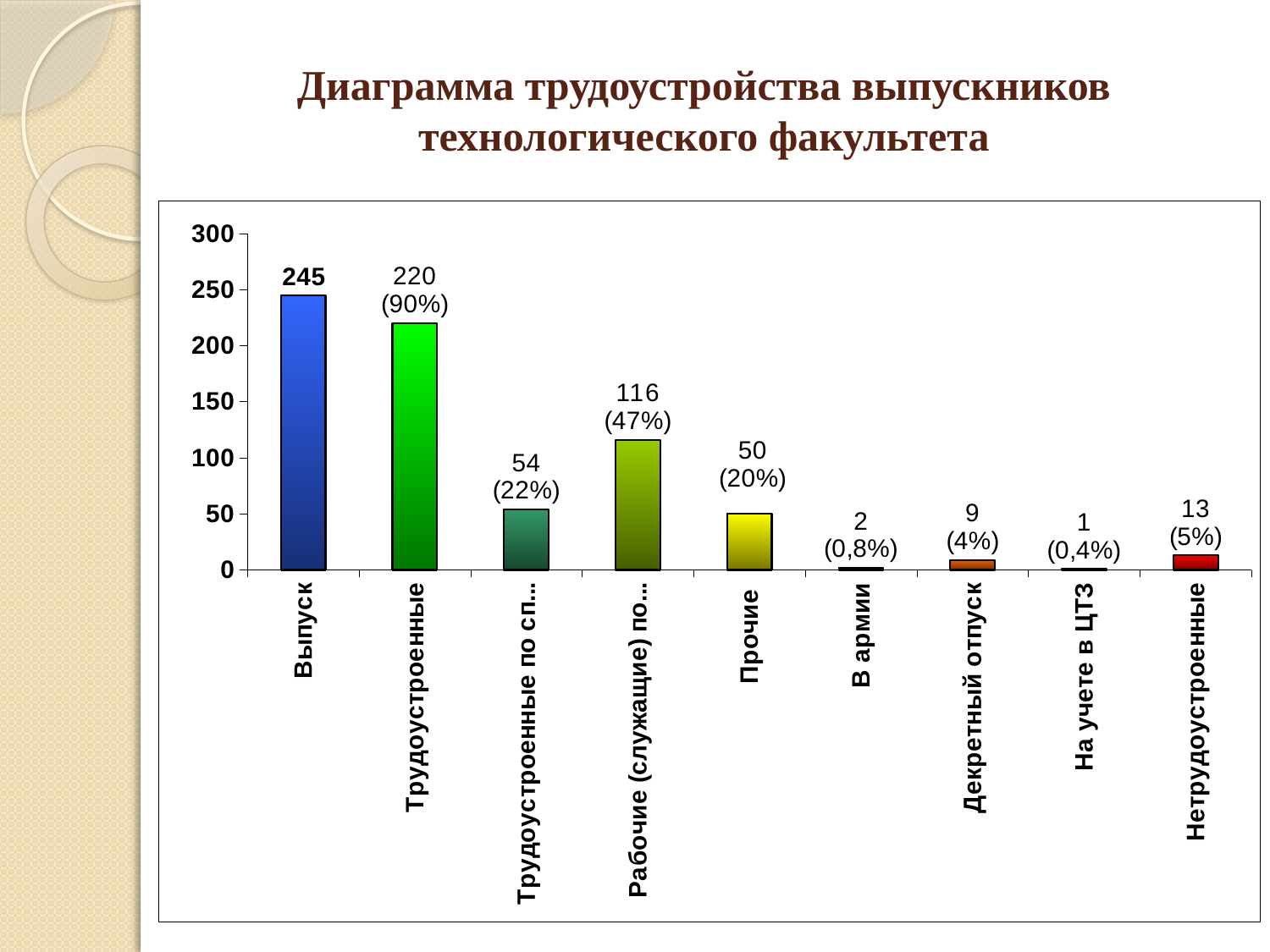
Which category has the lowest value? На учете в ЦТЗ What is the value for Выпуск? 245 What kind of chart is shown on the slide? Bar chart Which category has the highest value? Выпуск What is the difference between the values for Выпуск and Трудоустроенные? 25 Which is larger, the value for Декретный отпуск or the value for Нетрудоустроенные? Нетрудоустроенные What percentage is shown for Декретный отпуск? 4% How many categories are shown on the x axis? 9 What is the title of the slide? Диаграмма трудоустройства выпускников технологического факультета What is the value for Трудоустроенные? 220 What percentage is shown for Прочие? 20% What is the value for Нетрудоустроенные? 13